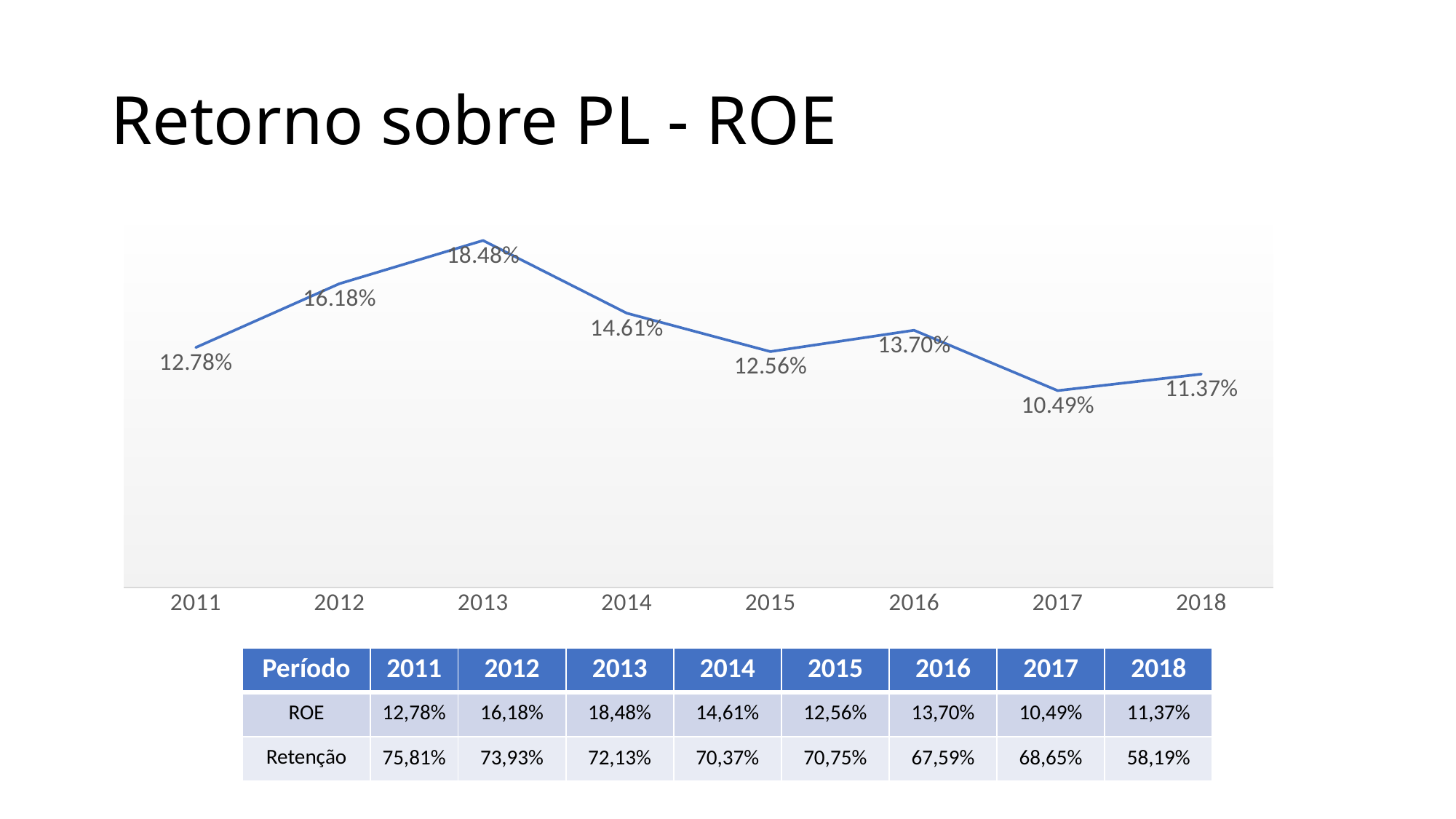
What is the ROE value shown for 2017? 10.49% Does the ROE rise or fall from 2011 to 2013? Rise What kind of chart is shown on the slide? Line chart Which year has the highest ROE on the chart? 2013 Which year has the lowest ROE on the chart? 2017 How many years are plotted on the chart? 8 Which year has a higher ROE, 2012 or 2016? 2012 What is the ROE value shown for 2011? 12.78% What is the difference between the ROE in 2013 and the ROE in 2011? 5.70 percentage points Which year has a higher ROE, 2018 or 2014? 2014 What is the ROE value shown for 2013? 18.48% What is the difference between the ROE in 2014 and the ROE in 2015? 2.05 percentage points